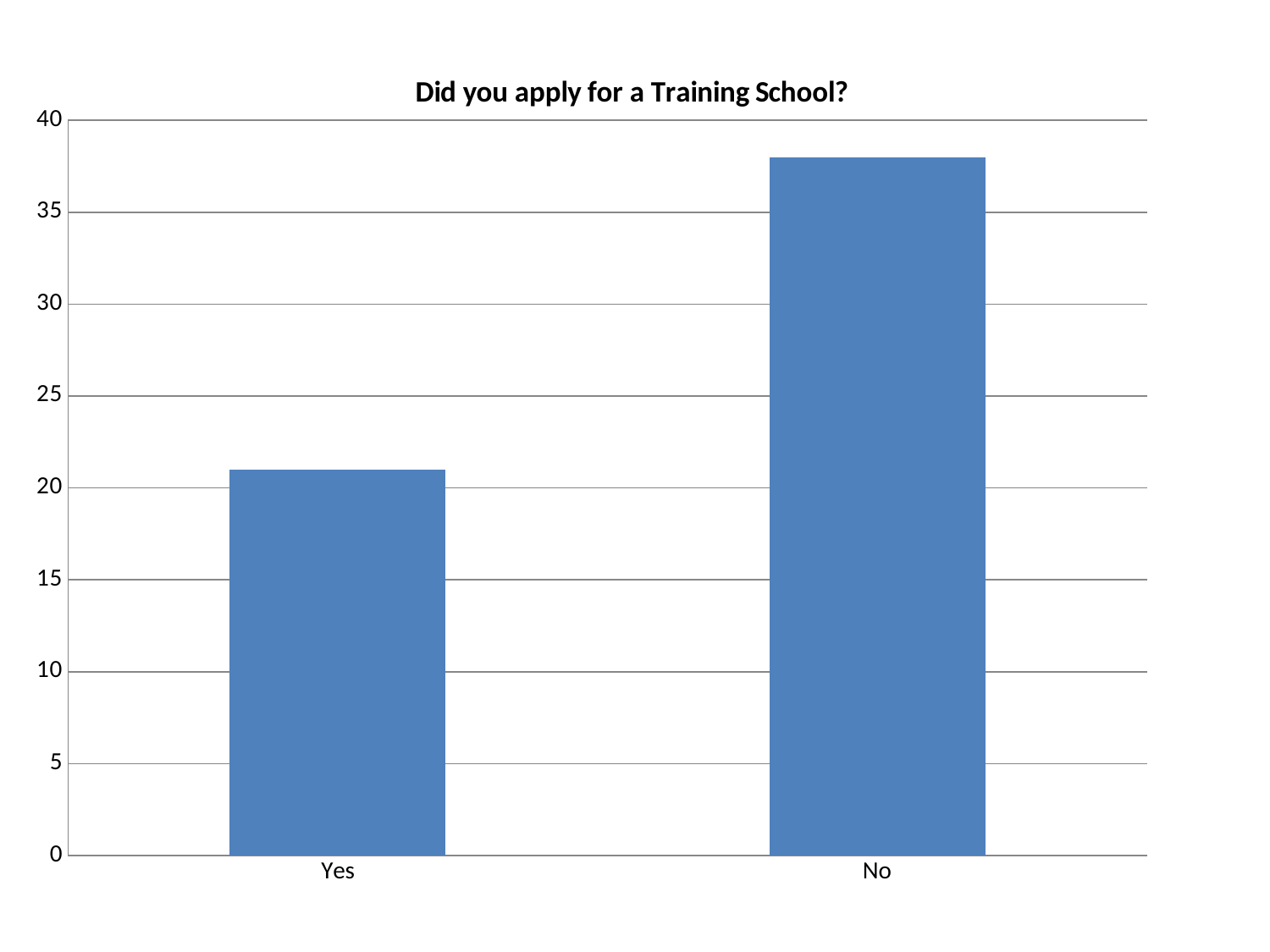
Which is larger, the value for Yes or the value for No? No Is the value for No greater or less than 40? less Which category has the highest value? No Is the value for No greater or less than 35? greater Do the values rise or fall from Yes to No along the x axis? rise How many categories are shown on the x axis? 2 What colour are the bars in the chart? blue What is the title of the chart? Did you apply for a Training School? What kind of chart is shown on the slide? bar chart Which category has the lowest value? Yes Is the value for Yes greater or less than 25? less